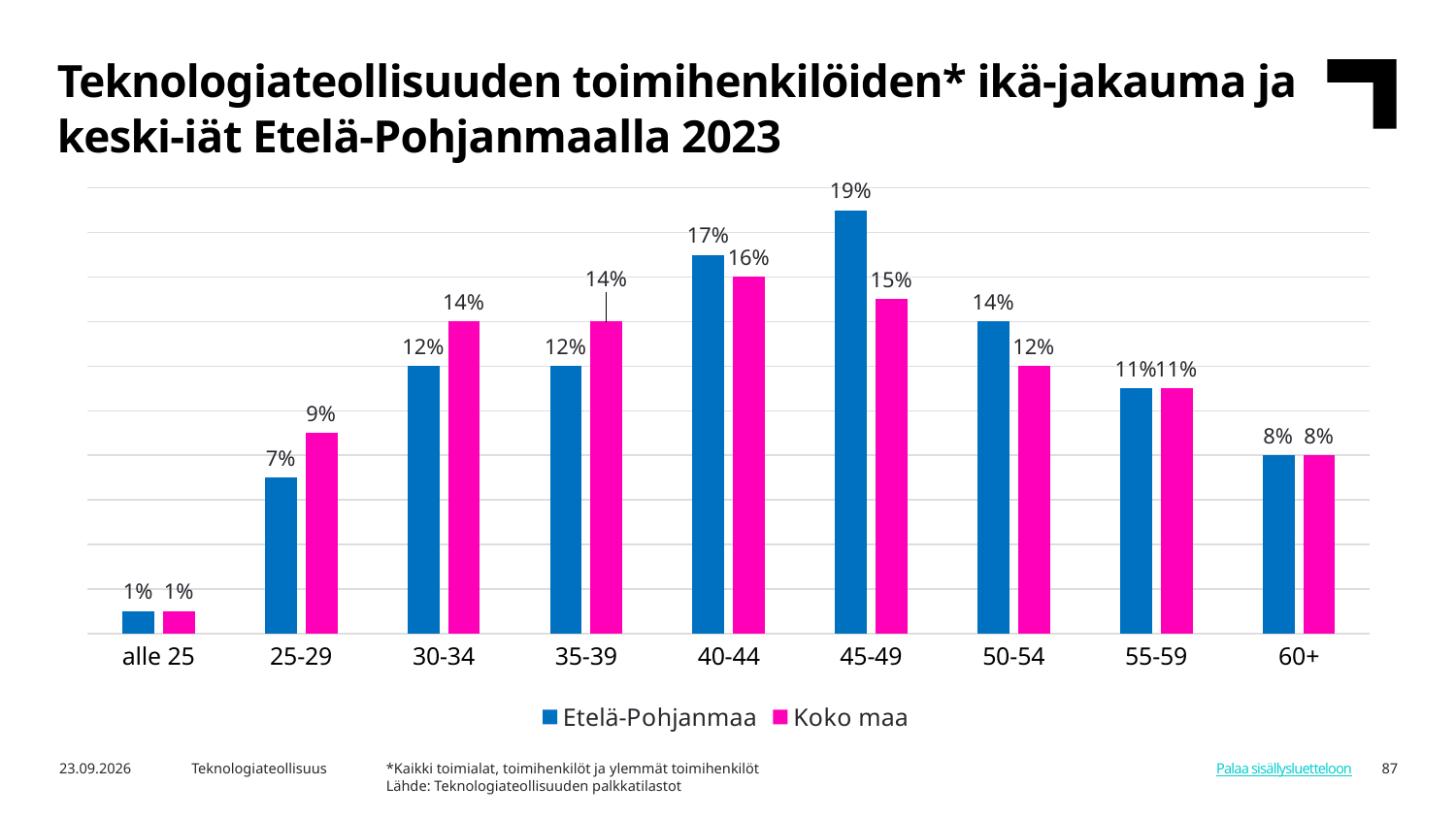
What is the value for Etelä-Pohjanmaa in the 45-49 age group? 19% How many age groups are shown on the x axis? 9 How many series does the legend list? 2 Which age group has the highest value for Etelä-Pohjanmaa? 45-49 What kind of chart is shown on the slide? Bar chart Which is larger in the 50-54 age group: Etelä-Pohjanmaa or Koko maa? Etelä-Pohjanmaa What is the value for Koko maa in the 40-44 age group? 16% Which colour represents Koko maa in the chart? Magenta (pink) Which age group has the lowest value for Koko maa? alle 25 What is the difference between the Etelä-Pohjanmaa and Koko maa values in the 45-49 age group? 4 percentage points What is the value for Koko maa in the 25-29 age group? 9% Which is larger in the 30-34 age group: Etelä-Pohjanmaa or Koko maa? Koko maa